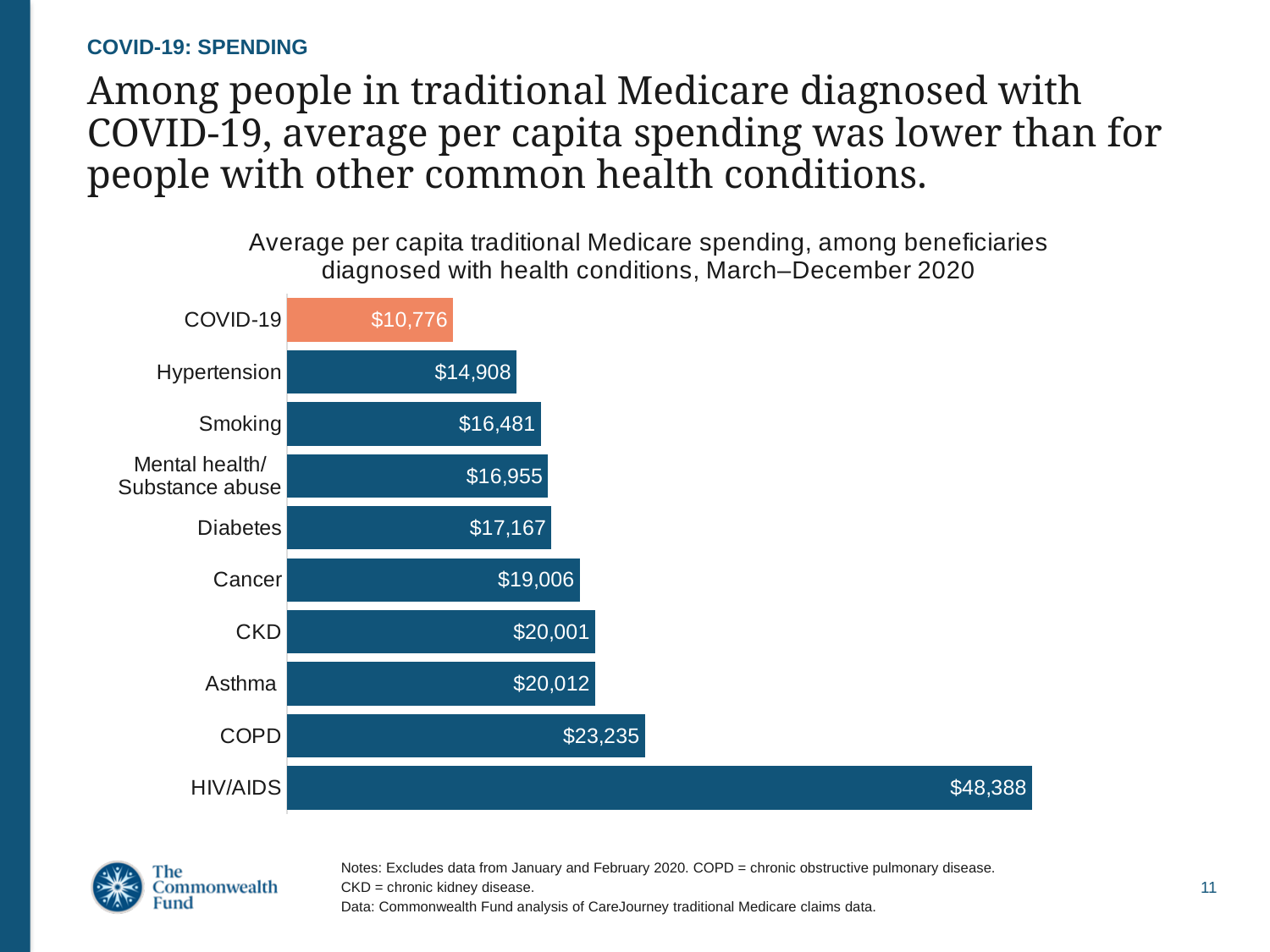
What is the average per capita spending for beneficiaries diagnosed with COPD? $23,235 How many health conditions are shown in the chart? 10 What is the average per capita traditional Medicare spending for beneficiaries diagnosed with COVID-19? $10,776 Which has higher average per capita spending, COPD or CKD? COPD Which health condition has the highest average per capita spending? HIV/AIDS Which health condition has the lowest average per capita spending? COVID-19 Which has higher average per capita spending, Diabetes or Smoking? Diabetes What is the difference in average per capita spending between Cancer and Hypertension? $4,098 How much higher is average per capita spending for HIV/AIDS than for COVID-19? $37,612 What is the average per capita spending for beneficiaries with Mental health/Substance abuse conditions? $16,955 Which bar is shown in a different colour (orange) from the others? COVID-19 What type of chart is used on this slide? Bar chart